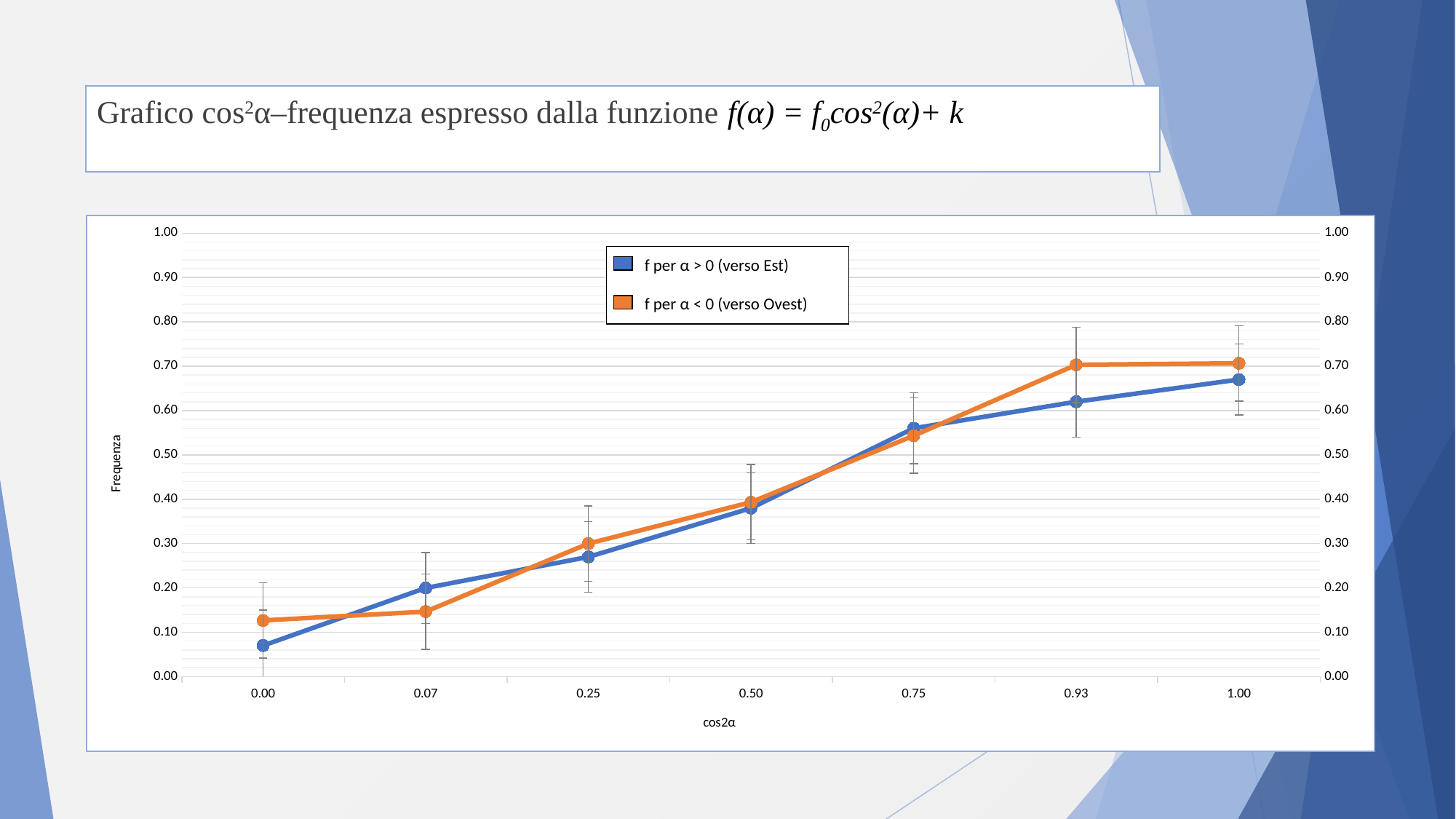
How many cos2α values are plotted along the x axis? 7 Is the value of 'f per α > 0 (verso Est)' at cos2α = 0.00 greater or less than 0.10? less Is the value of 'f per α < 0 (verso Ovest)' at cos2α = 0.75 greater or less than 0.50? greater Is the value of 'f per α > 0 (verso Est)' at cos2α = 1.00 greater or less than 0.60? greater What kind of chart is shown on the slide? Line chart At which cos2α value does the series 'f per α > 0 (verso Est)' reach its lowest point? 0.00 At cos2α = 0.00, which series has the higher value: 'f per α > 0 (verso Est)' or 'f per α < 0 (verso Ovest)'? f per α < 0 (verso Ovest) At cos2α = 0.07, which series has the higher value: 'f per α > 0 (verso Est)' or 'f per α < 0 (verso Ovest)'? f per α > 0 (verso Est) Do the values of the series 'f per α > 0 (verso Est)' rise or fall as cos2α increases? Rise How many series does the legend list? 2 What is the label of the y axis? Frequenza